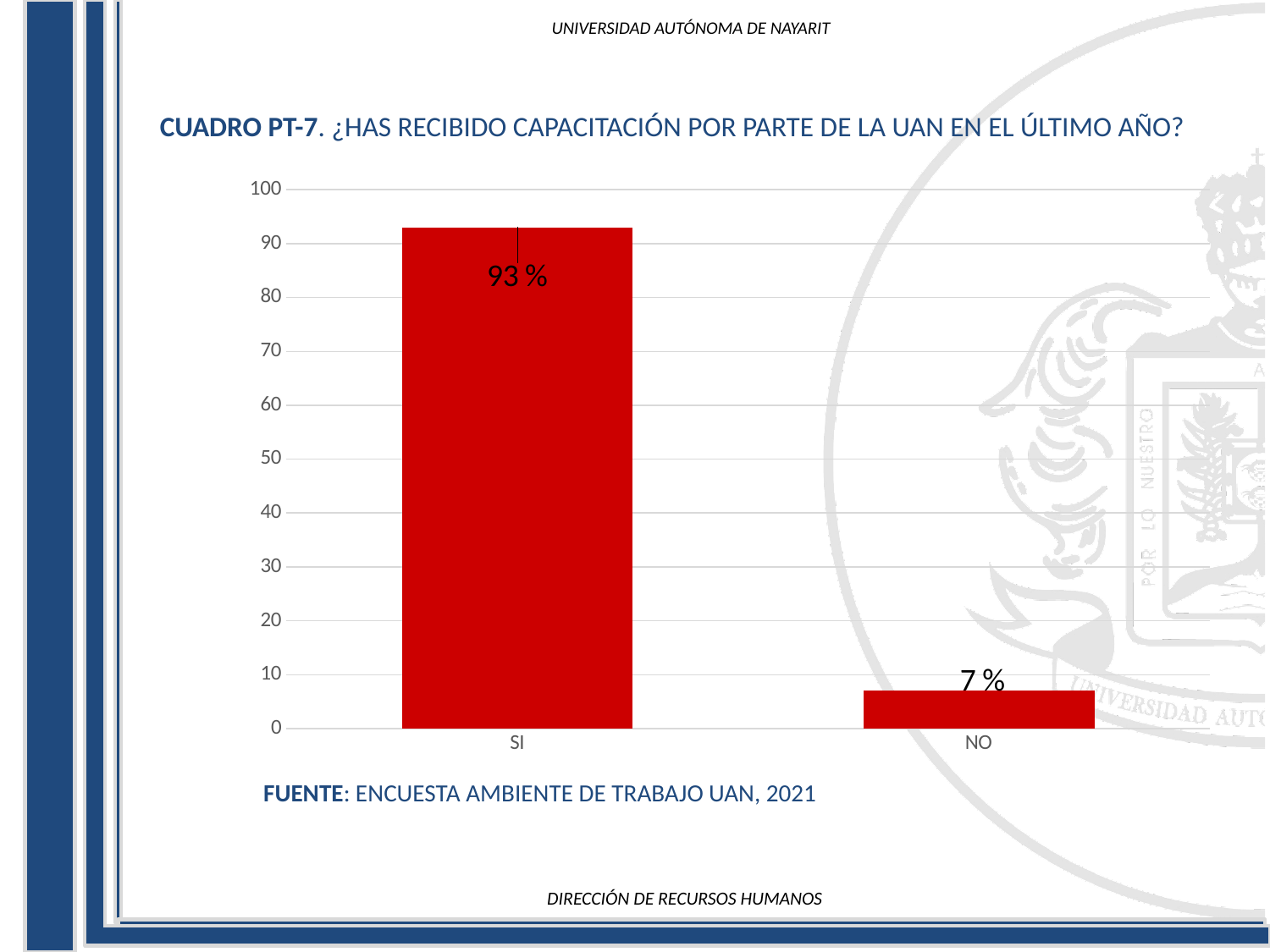
Which category has the highest value? SI Which is larger, the value for SI or the value for NO? SI Is the value for SI greater or less than 90? greater What is the value for NO? 7 % What is the source cited below the chart? ENCUESTA AMBIENTE DE TRABAJO UAN, 2021 What colour are the bars in the chart? red Which category has the lowest value? NO Is the value for NO greater or less than 10? less What kind of chart is shown on the slide? bar chart How many categories are shown on the x axis? 2 What is the difference between the values for SI and NO? 86 % What is the value for SI? 93 %